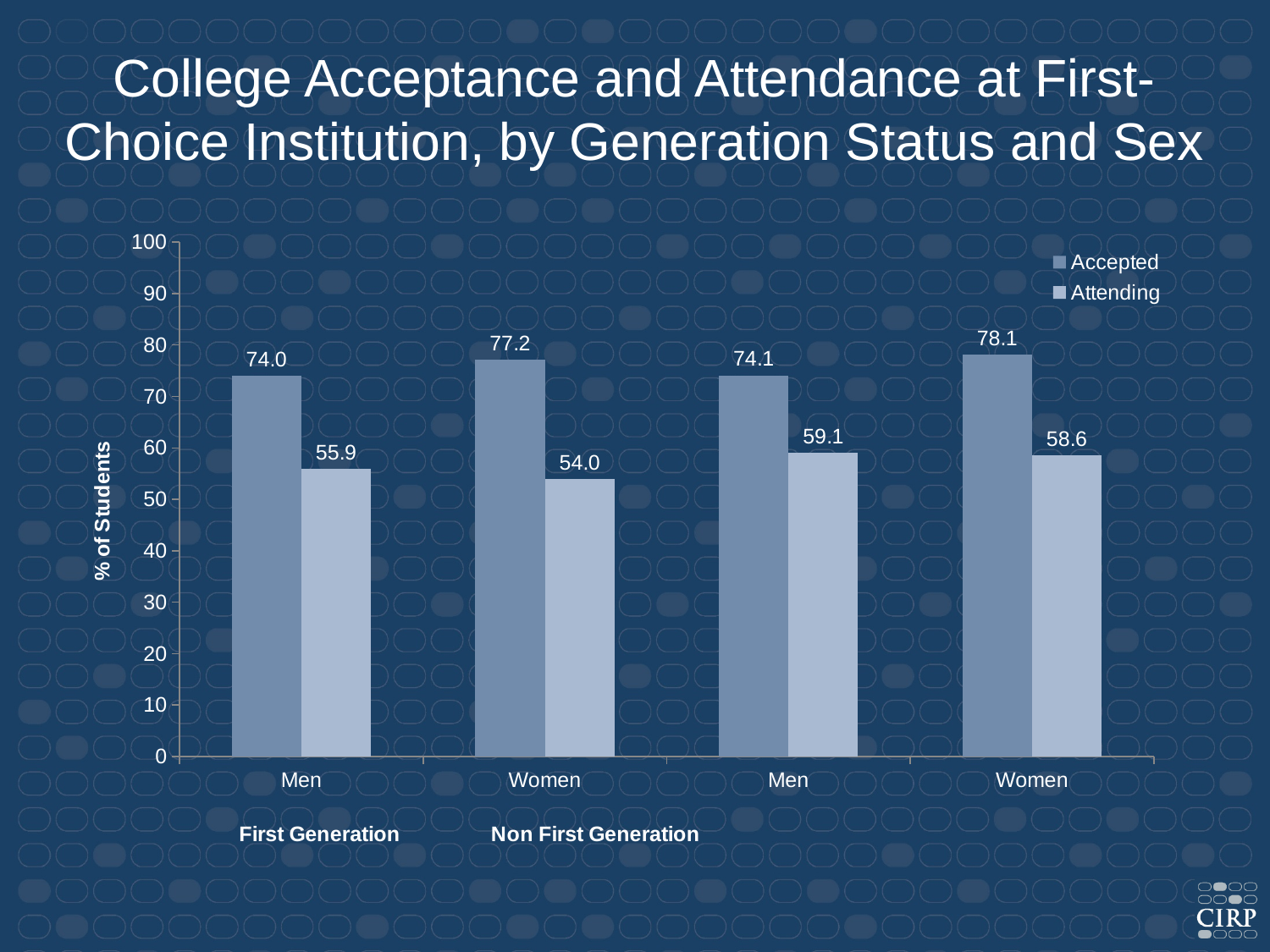
What is the label on the y axis? % of Students Is the Accepted value for First Generation Women larger or smaller than the Accepted value for First Generation Men? larger How many series does the legend list? 2 How many category groups are shown along the x axis? 4 What is the Attending value for First Generation Women? 54.0 Which group has the highest Accepted value? Non First Generation Women What is the difference between the Accepted and Attending values for First Generation Men? 18.1 What is the Accepted value for First Generation Men? 74.0 What is the Accepted value for Non First Generation Women? 78.1 What type of chart is shown on the slide? bar chart Which group has the lowest Attending value? First Generation Women What is the Attending value for Non First Generation Men? 59.1